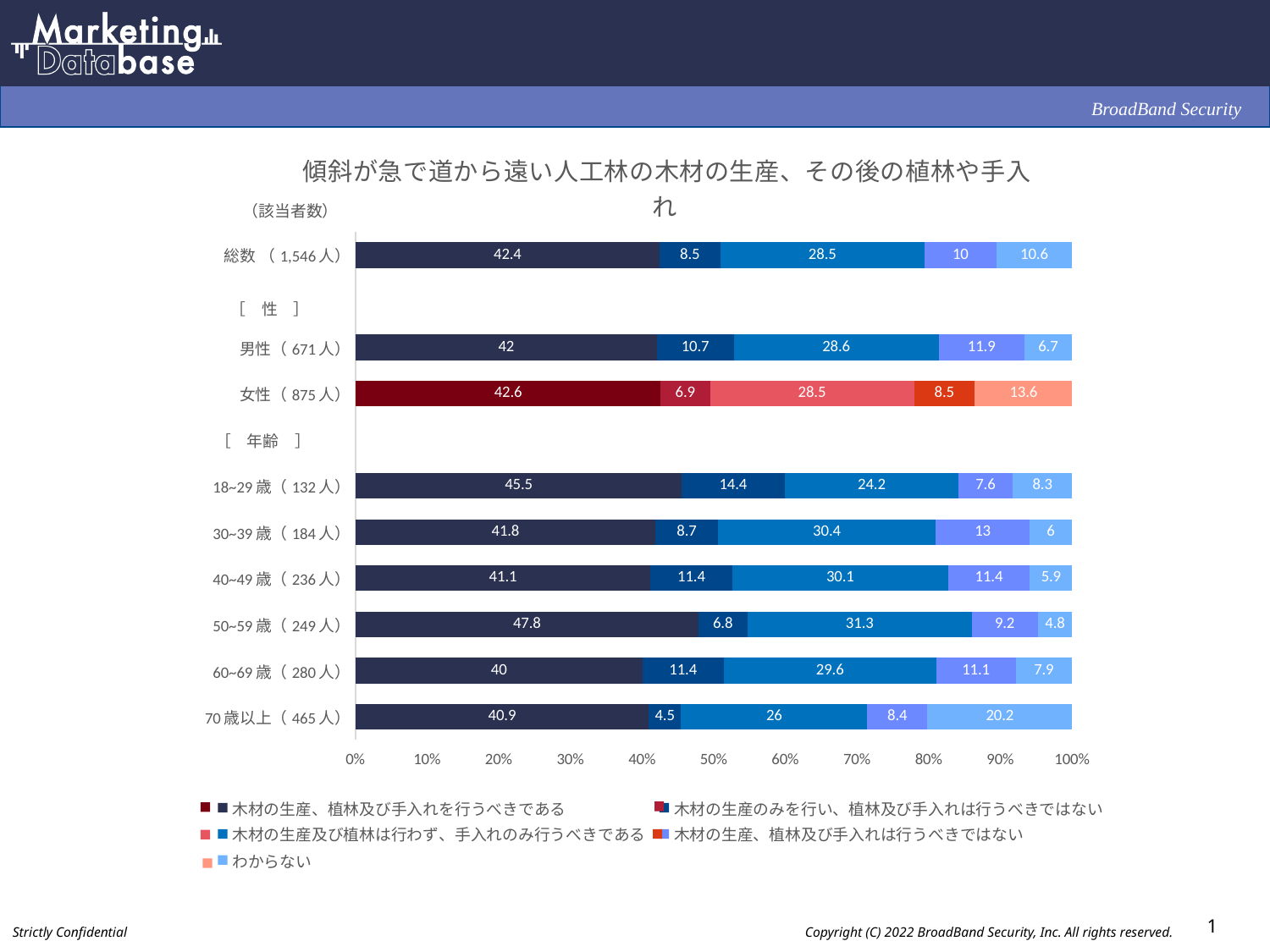
Which category has the highest value for 「木材の生産、植林及び手入れを行うべきである」? 50~59歳 (249人) What is the title of the chart? 傾斜が急で道から遠い人工林の木材の生産、その後の植林や手入れ What is the value of 「木材の生産のみを行い、植林及び手入れは行うべきではない」 for 18~29歳 (132人)? 14.4 What is the value of 「わからない」 for 70歳以上 (465人)? 20.2 What type of chart is shown on the slide? stacked bar chart Which category has the lowest value for 「木材の生産のみを行い、植林及び手入れは行うべきではない」? 70歳以上 (465人) What is the value of 「木材の生産、植林及び手入れは行うべきではない」 for 女性 (875人)? 8.5 What is the difference between the 「わからない」 values for 女性 (875人) and 男性 (671人)? 6.9 Which is larger, the 「木材の生産及び植林は行わず、手入れのみ行うべきである」 value for 30~39歳 (184人) or for 18~29歳 (132人)? 30~39歳 (184人) How many category bars are plotted in the chart? 9 What is the value of 「木材の生産、植林及び手入れを行うべきである」 for 総数 (1,546人)? 42.4 How many series does the legend list? 5